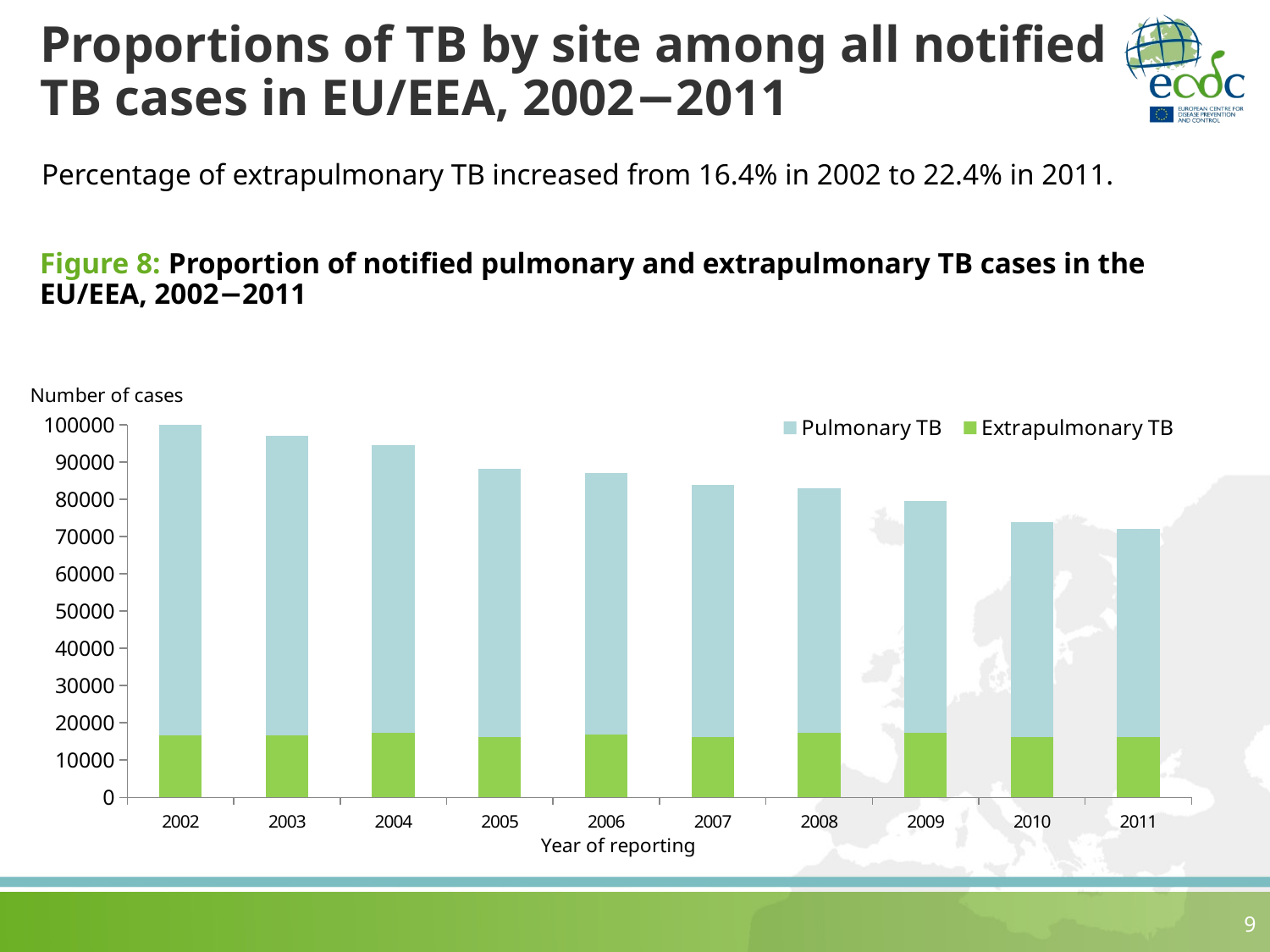
Which year has the shortest total bar in the chart? 2011 How many years are plotted along the x axis of the chart? 10 Which series is shown in green in the chart? Extrapulmonary TB Is the total number of cases in 2011 greater or less than 80000? less Is the number of extrapulmonary TB cases in 2002 greater or less than 20000? less Is the total number of cases in 2002 greater or less than 90000? greater Which year has the tallest total bar in the chart? 2002 What is the title of the x axis of the chart? Year of reporting Which year has the larger total number of cases, 2003 or 2010? 2003 What kind of chart is shown on the slide? bar chart How many series does the chart's legend list? 2 Does the total number of cases rise or fall from 2002 to 2011? fall